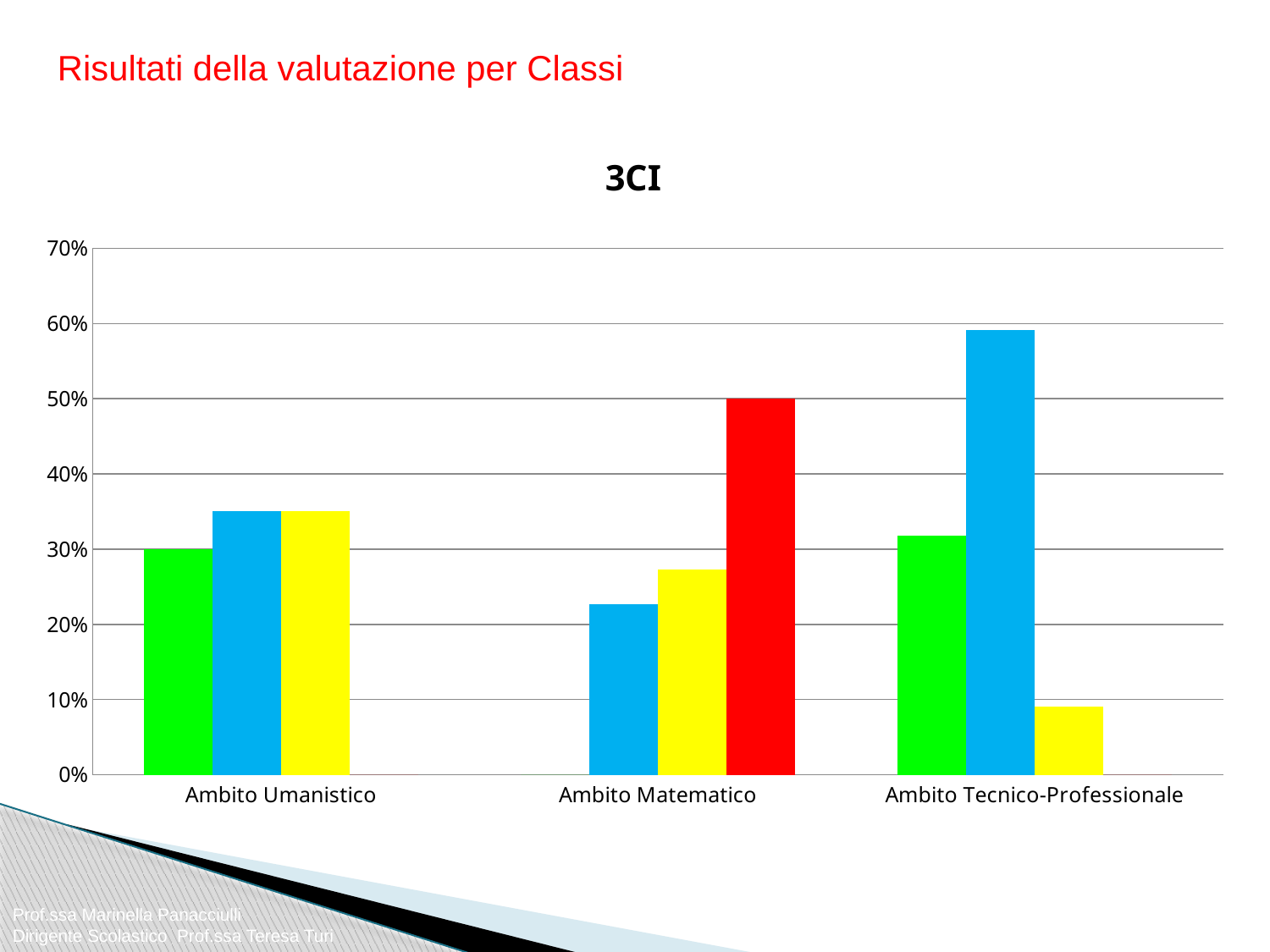
Which category contains the shortest bar in the chart? Ambito Tecnico-Professionale What is the value of the green bar for Ambito Umanistico? 30% What is the value of the red bar for Ambito Matematico? 50% Is the value of the blue bar for Ambito Tecnico-Professionale greater or less than 50%? greater Which is larger: the red bar for Ambito Matematico or the blue bar for Ambito Tecnico-Professionale? the blue bar for Ambito Tecnico-Professionale How many categories are shown on the x axis of the chart? 3 Is the value of the yellow bar for Ambito Tecnico-Professionale greater or less than 20%? less What is the title of the chart? 3CI In which category does a red bar appear? Ambito Matematico In which category does the tallest bar of the chart appear? Ambito Tecnico-Professionale Is the value of the blue bar for Ambito Matematico greater or less than 30%? less What kind of chart is shown on the slide? bar chart